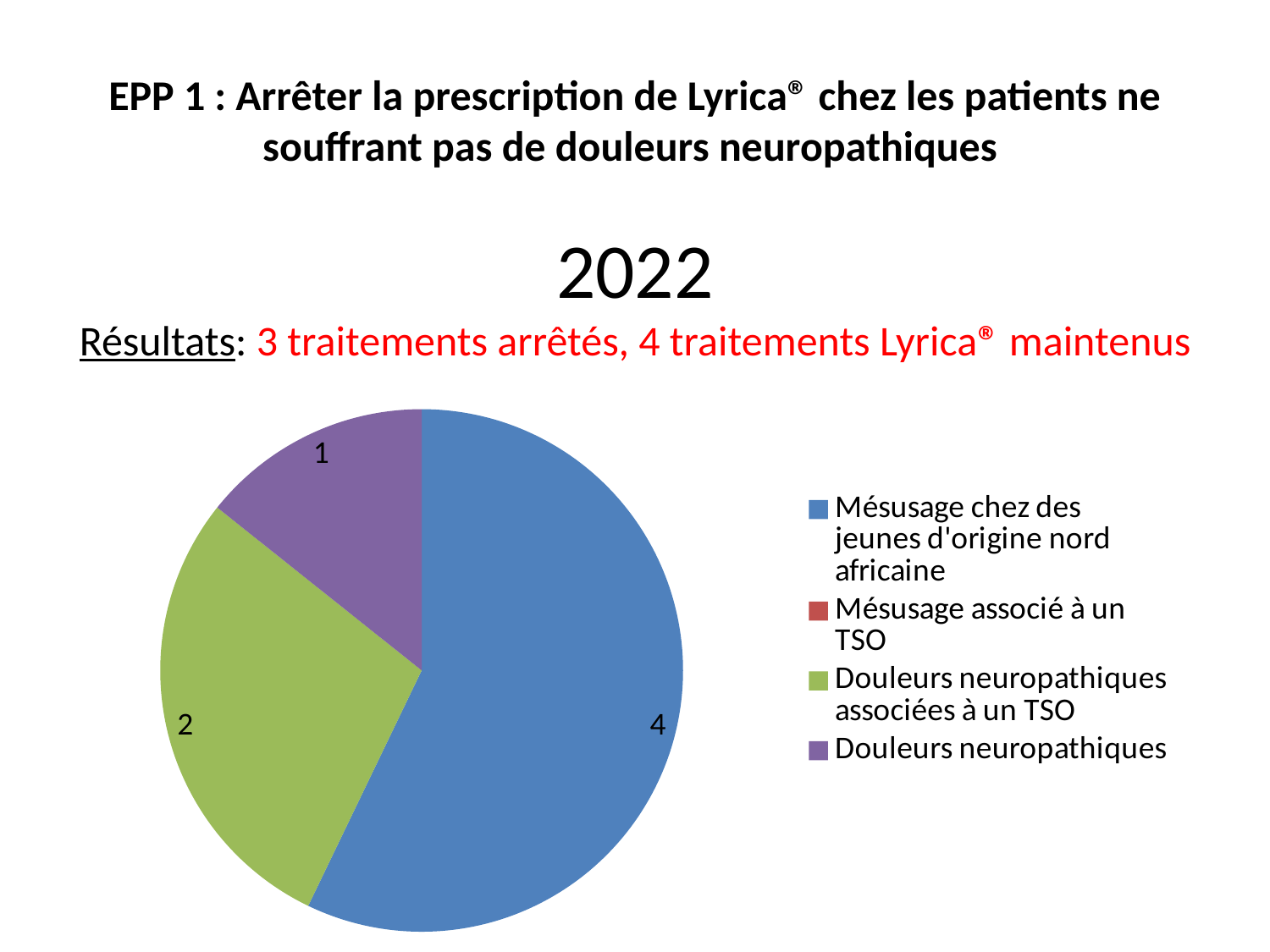
Which category has the largest slice of the pie? Mésusage chez des jeunes d'origine nord africaine Which is larger: the slice for "Douleurs neuropathiques associées à un TSO" or the slice for "Douleurs neuropathiques"? Douleurs neuropathiques associées à un TSO What is the difference between the value for "Douleurs neuropathiques associées à un TSO" and the value for "Douleurs neuropathiques"? 1 What is the value of the slice for "Mésusage chez des jeunes d'origine nord africaine"? 4 How many entries does the legend list? 4 What is the value of the slice for "Douleurs neuropathiques associées à un TSO"? 2 What is the total of the labelled slice values in the pie? 7 What is the value of the slice for "Douleurs neuropathiques"? 1 What colour is the legend marker for "Douleurs neuropathiques"? purple What kind of chart is shown on the slide? pie chart What is the difference between the value for "Mésusage chez des jeunes d'origine nord africaine" and the value for "Douleurs neuropathiques associées à un TSO"? 2 How many slices with data labels are visible in the pie? 3